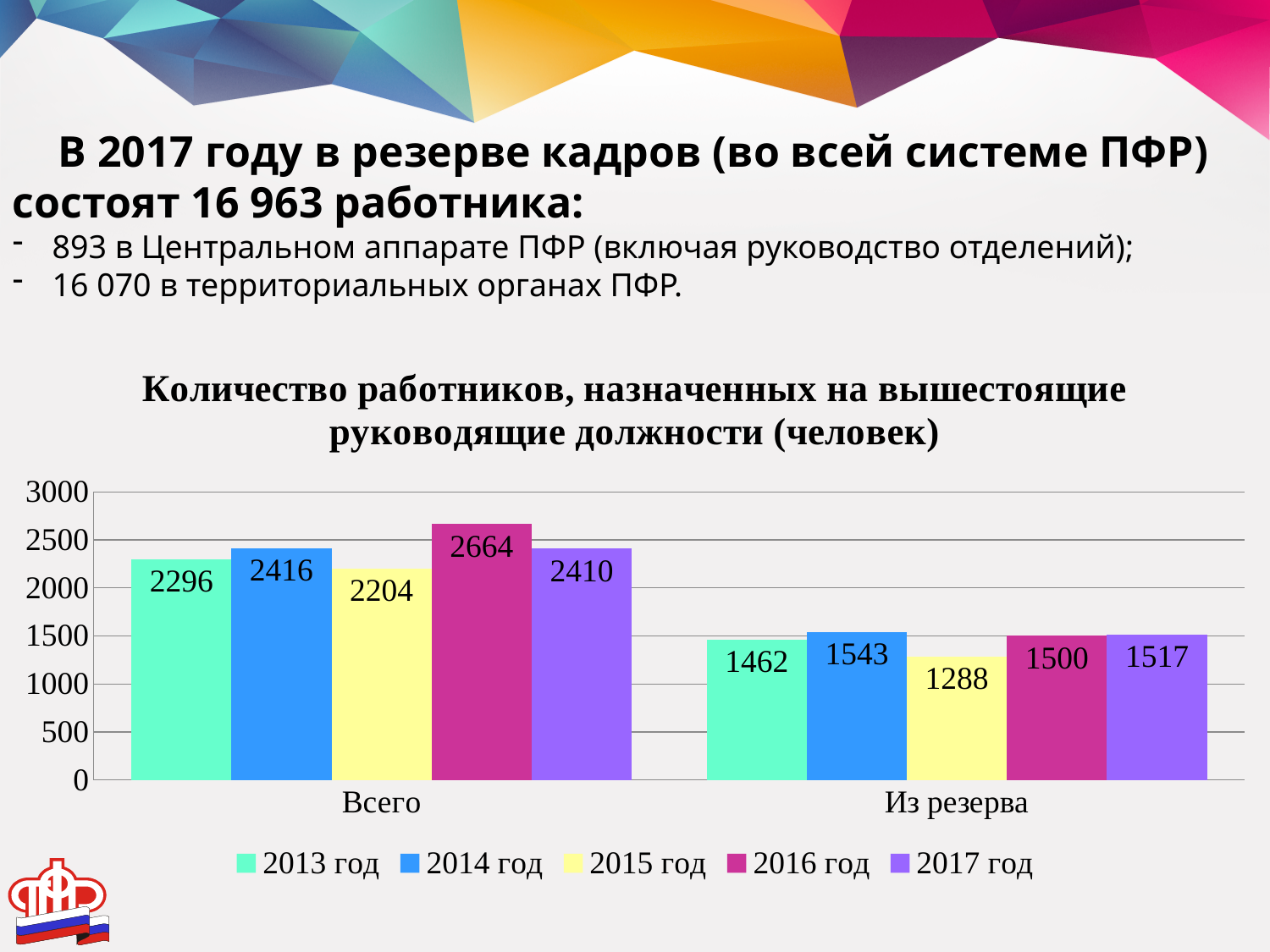
Which year has the lowest value in the Из резерва category? 2015 год What is the value for 2015 год in the Из резерва category? 1288 What is the value for 2016 год in the Всего category? 2664 What kind of chart is shown on the slide? bar chart What is the difference between the 2016 год and 2015 год values in the Всего category? 460 How many series does the legend list? 5 How many categories are shown on the x axis? 2 Which year has the highest value in the Всего category? 2016 год What is the value for 2017 год in the Всего category? 2410 What is the title of the chart? Количество работников, назначенных на вышестоящие руководящие должности (человек) Which is larger in the Из резерва category: the value for 2014 год or the value for 2013 год? 2014 год Is the value for 2013 год in the Из резерва category greater or less than 1500? less